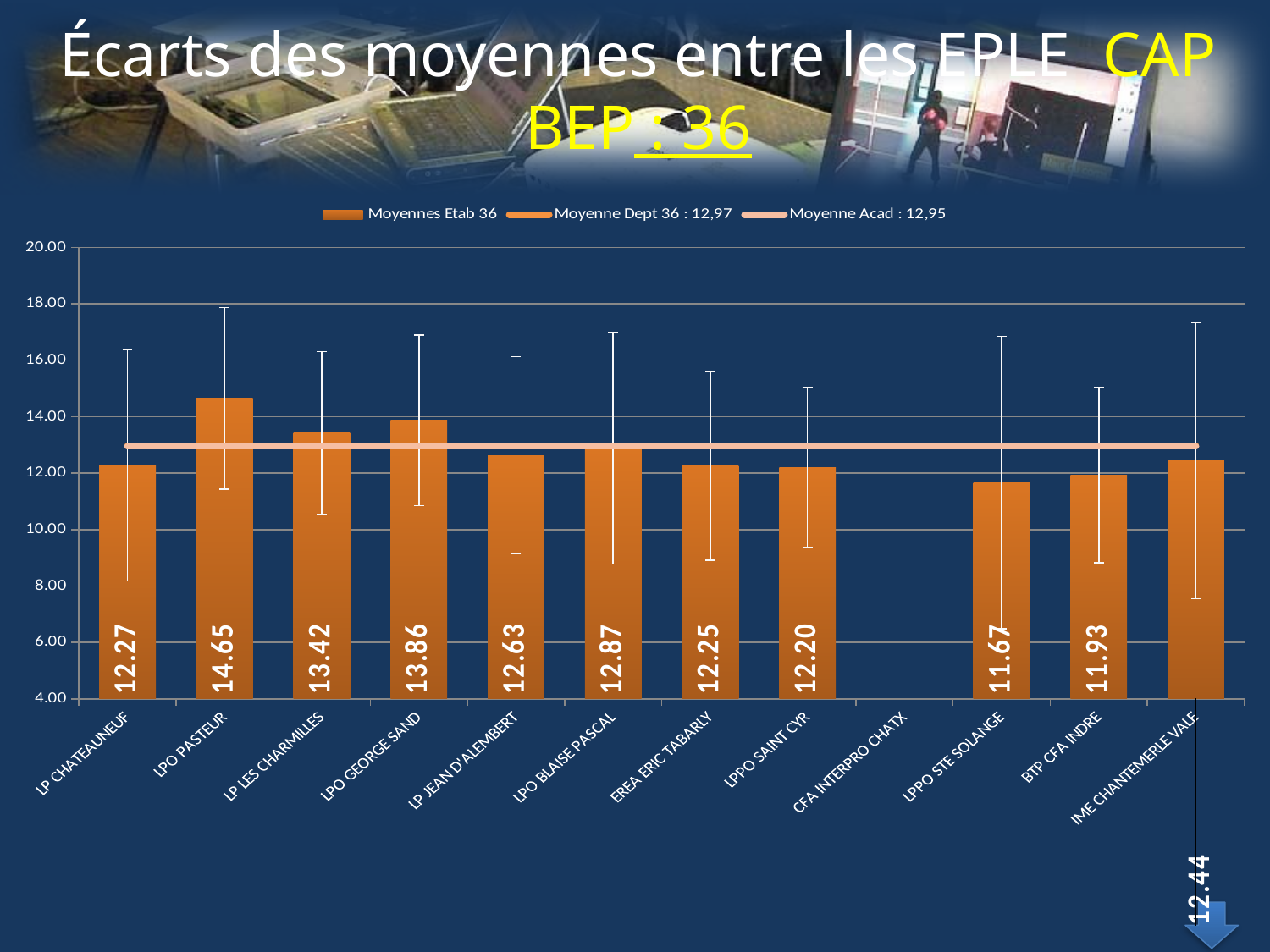
How many establishments are listed on the x axis? 12 What kind of chart is shown? bar chart What is the value for LPO PASTEUR? 14.65 What is the value for LPPO STE SOLANGE? 11.67 Is the value for LPO PASTEUR greater or less than 14.00? greater Which establishment has the highest value? LPO PASTEUR What is the difference between the values for LPO GEORGE SAND and LP LES CHARMILLES? 0.44 Which is larger, the value for LP CHATEAUNEUF or the value for EREA ERIC TABARLY? LP CHATEAUNEUF How many series does the legend list? 3 Which establishment has the lowest value among those with a bar? LPPO STE SOLANGE What is the value for LP JEAN D'ALEMBERT? 12.63 What is the difference between the values for LPO PASTEUR and LPPO STE SOLANGE? 2.98